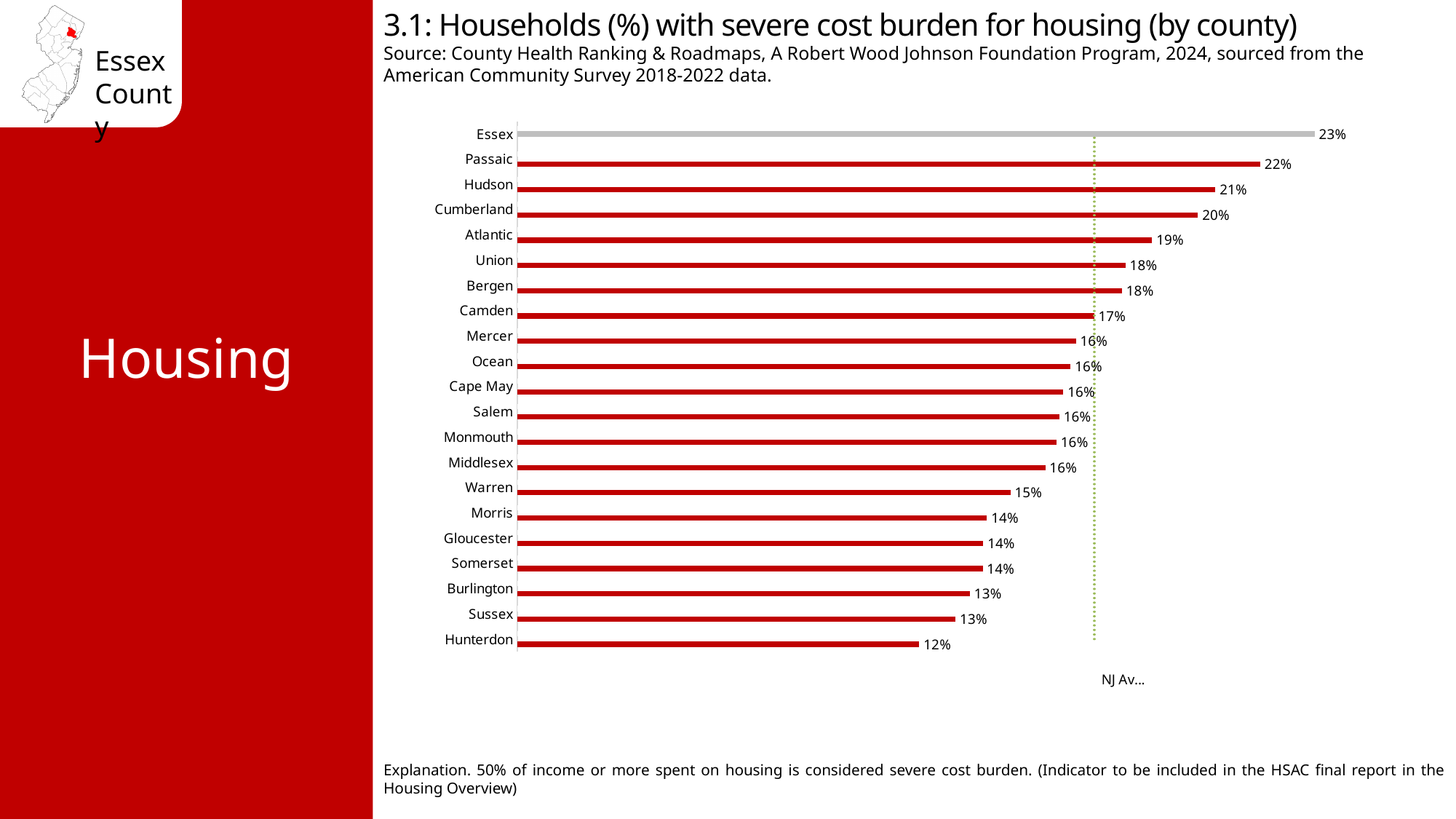
What is the value for Camden? 17% What is the difference between the values for Essex and Hunterdon? 11% Which is larger, the value for Hudson or the value for Morris? Hudson What is the value for Essex? 23% What is the value for Warren? 15% How many counties are shown in the chart? 21 Which county has the highest value? Essex What is the value for Hunterdon? 12% What kind of chart is this? Bar chart What is the difference between the values for Passaic and Atlantic? 3% Which county's bar is shown in a different colour (grey) from the others? Essex Which county has the lowest value? Hunterdon